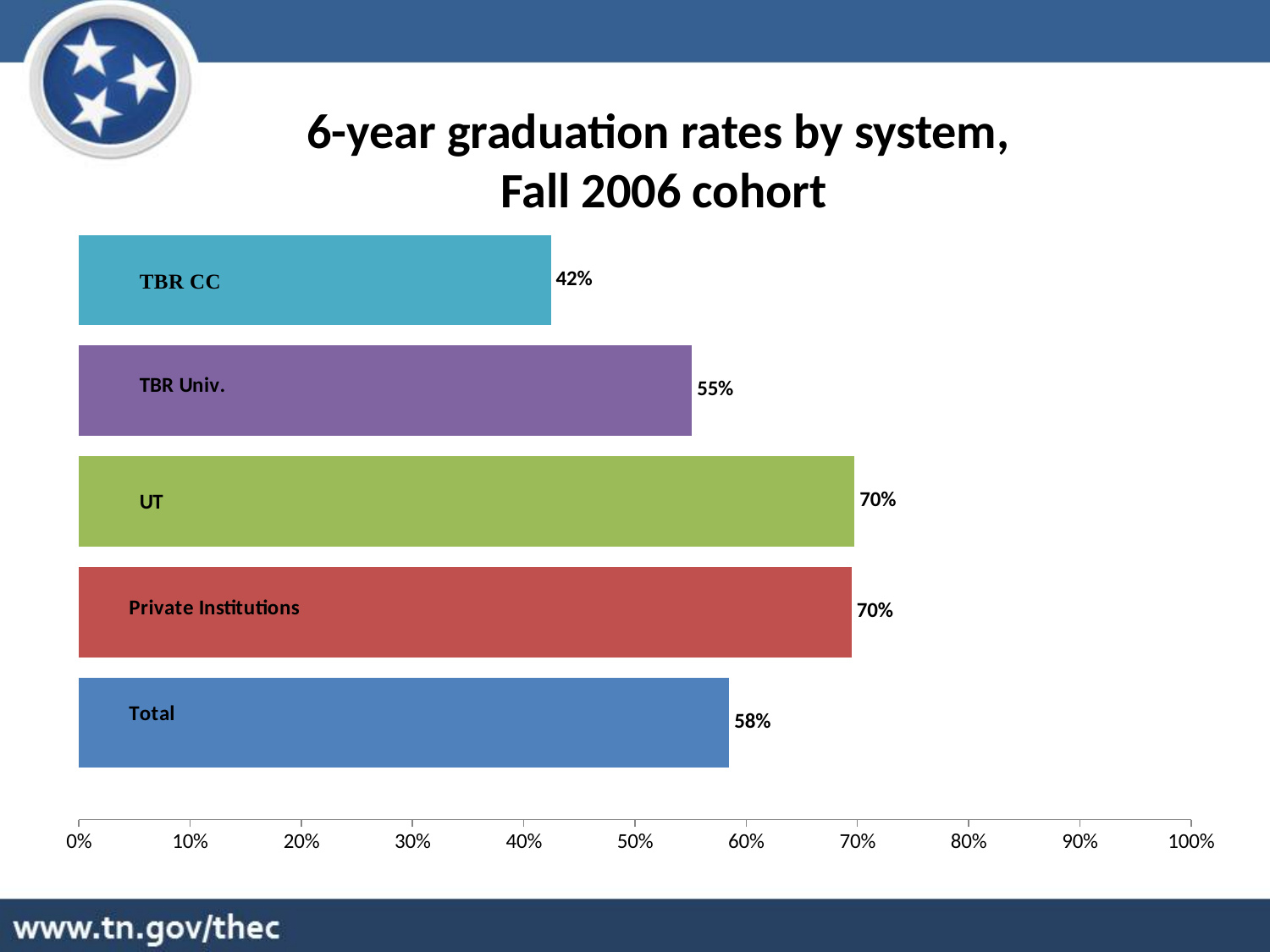
How many categories (bars) are shown on the chart? 5 Which system has the lowest 6-year graduation rate? TBR CC Is the graduation rate for TBR CC greater or less than 50%? less What is the 6-year graduation rate for TBR Univ.? 55% What is the difference between the Total graduation rate and the TBR Univ. rate? 3% What is the Total 6-year graduation rate shown on the chart? 58% Which has a higher 6-year graduation rate, TBR Univ. or Total? Total What is the title of the chart? 6-year graduation rates by system, Fall 2006 cohort What is the difference between the graduation rates of UT and TBR CC? 28% What is the 6-year graduation rate for Private Institutions? 70% What is the 6-year graduation rate for TBR CC? 42% What type of chart is shown on the slide? Bar chart